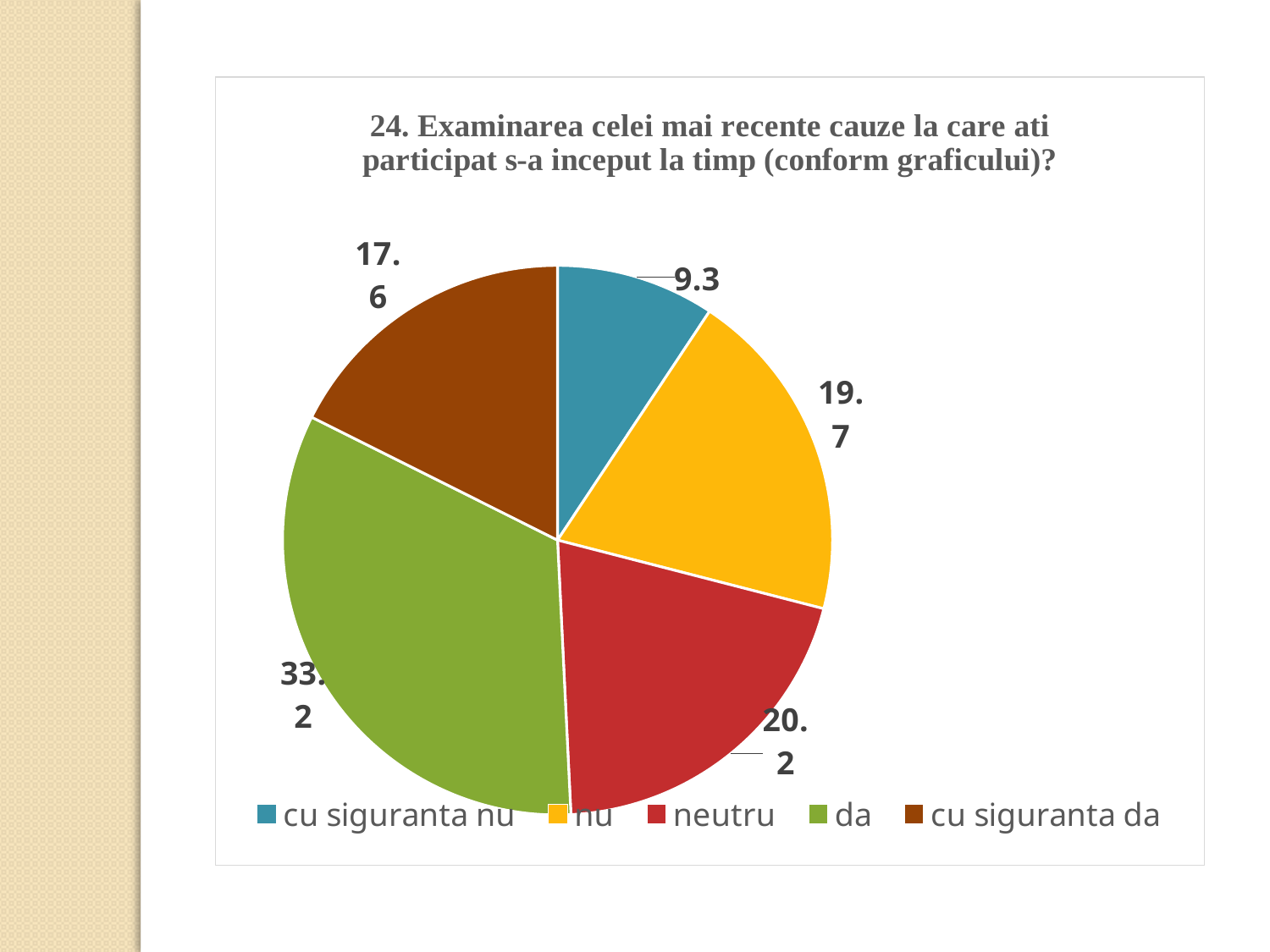
Which category has the largest slice of the pie? da Which category has the smallest slice of the pie? cu siguranta nu What kind of chart is shown on the slide? pie chart What is the value for "neutru" in the pie chart? 20.2 How many categories does the pie chart have? 5 What is the value for "da" in the pie chart? 33.2 What is the value for "cu siguranta da" in the pie chart? 17.6 Which is larger, the slice for "da" or the slice for "neutru"? da What is the value for "nu" in the pie chart? 19.7 What colour is the slice for "da" in the pie chart? green What is the value for "cu siguranta nu" in the pie chart? 9.3 What is the difference between the values for "da" and "cu siguranta da"? 15.6